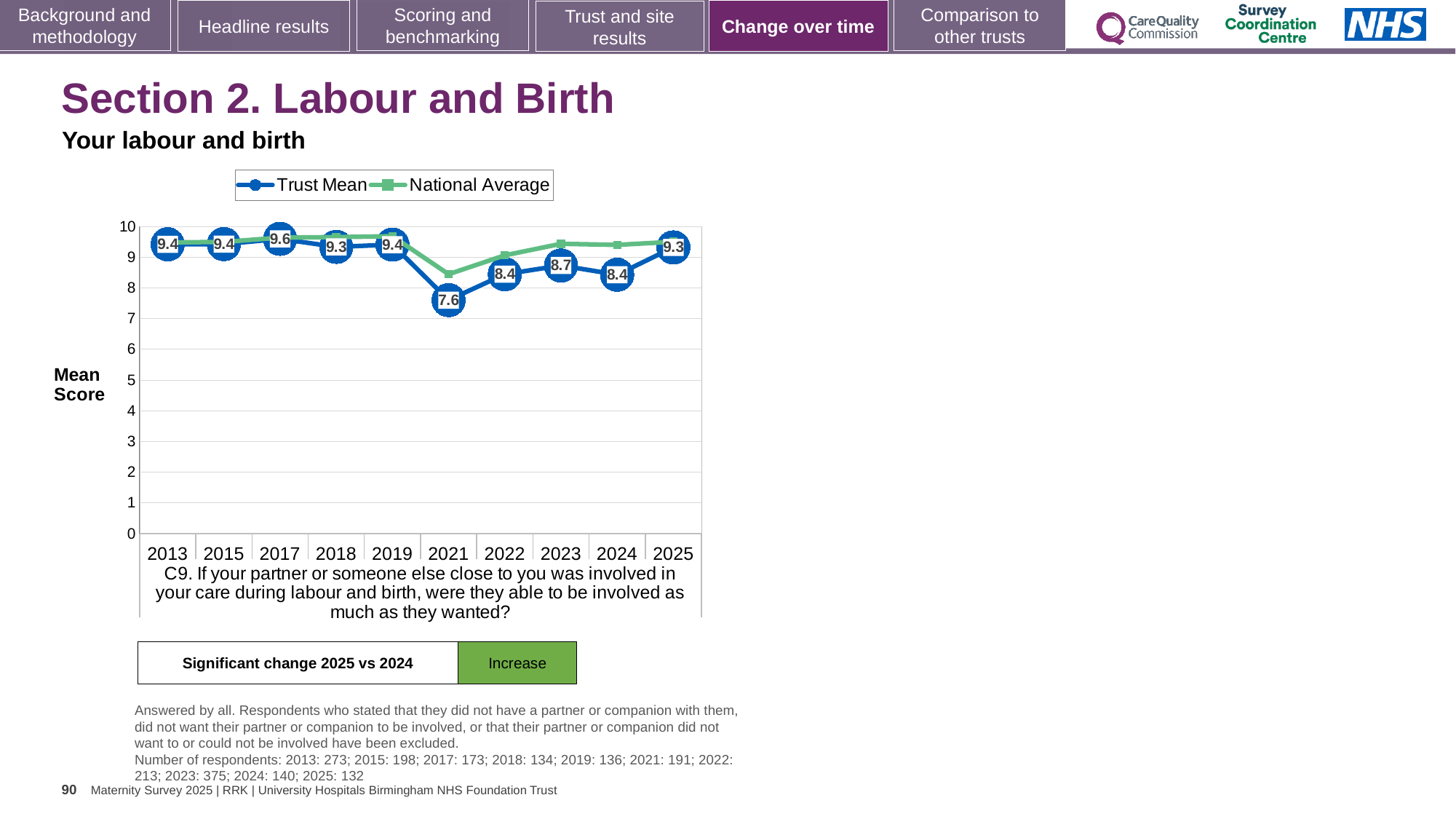
What is the Trust Mean score for 2021? 7.6 Which year has the larger Trust Mean score, 2022 or 2023? 2023 What is the Trust Mean score for 2023? 8.7 How many years are shown on the x axis of the chart? 10 How many series does the chart legend list? 2 In which year is the Trust Mean score highest? 2017 What kind of chart is shown on the slide? line chart Does the Trust Mean score rise or fall from 2024 to 2025? rise What is the Trust Mean score for 2025? 9.3 Is the National Average value for 2021 greater or less than 8? greater In which year is the Trust Mean score lowest? 2021 What is the difference between the Trust Mean score in 2025 and in 2024? 0.9